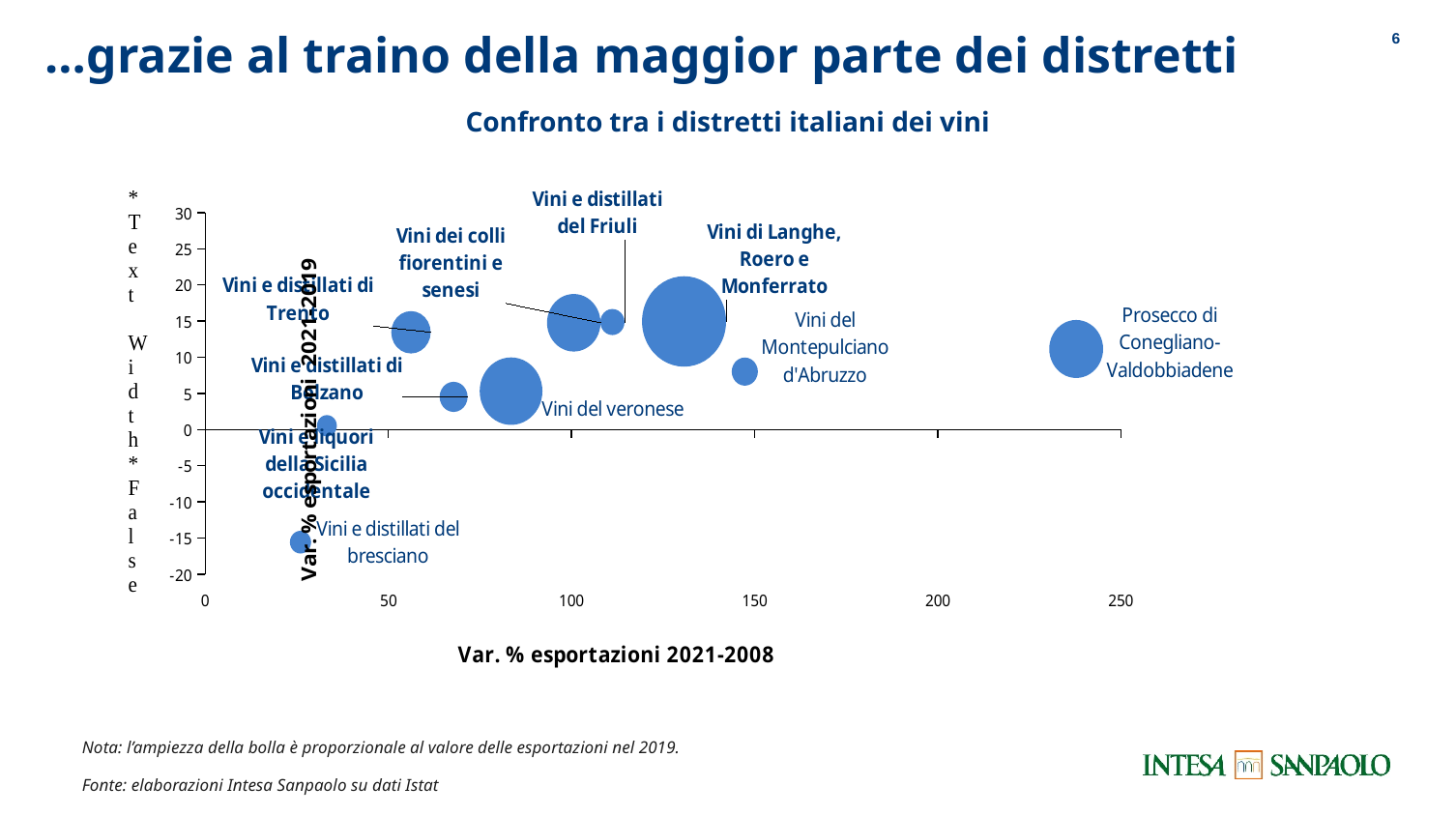
Is the vertical-axis value for Vini e distillati del bresciano greater or less than -10? less Which has the higher vertical-axis value: Vini del veronese or Vini e distillati del bresciano? Vini del veronese Which has the larger horizontal-axis value: Prosecco di Conegliano-Valdobbiadene or Vini e liquori della Sicilia occidentale? Prosecco di Conegliano-Valdobbiadene How many wine districts are plotted as bubbles in the chart? 10 Is the horizontal-axis value for Prosecco di Conegliano-Valdobbiadene greater or less than 200? greater What is the label of the horizontal axis of the chart? Var. % esportazioni 2021-2008 Is the horizontal-axis value for Vini del veronese greater or less than 100? less What is the title of the chart? Confronto tra i distretti italiani dei vini Which district has the highest value on the horizontal axis (Var. % esportazioni 2021-2008)? Prosecco di Conegliano-Valdobbiadene Which district has the lowest value on the vertical axis (Var. % esportazioni 2021-2019)? Vini e distillati del bresciano What kind of chart is shown on the slide? bubble chart